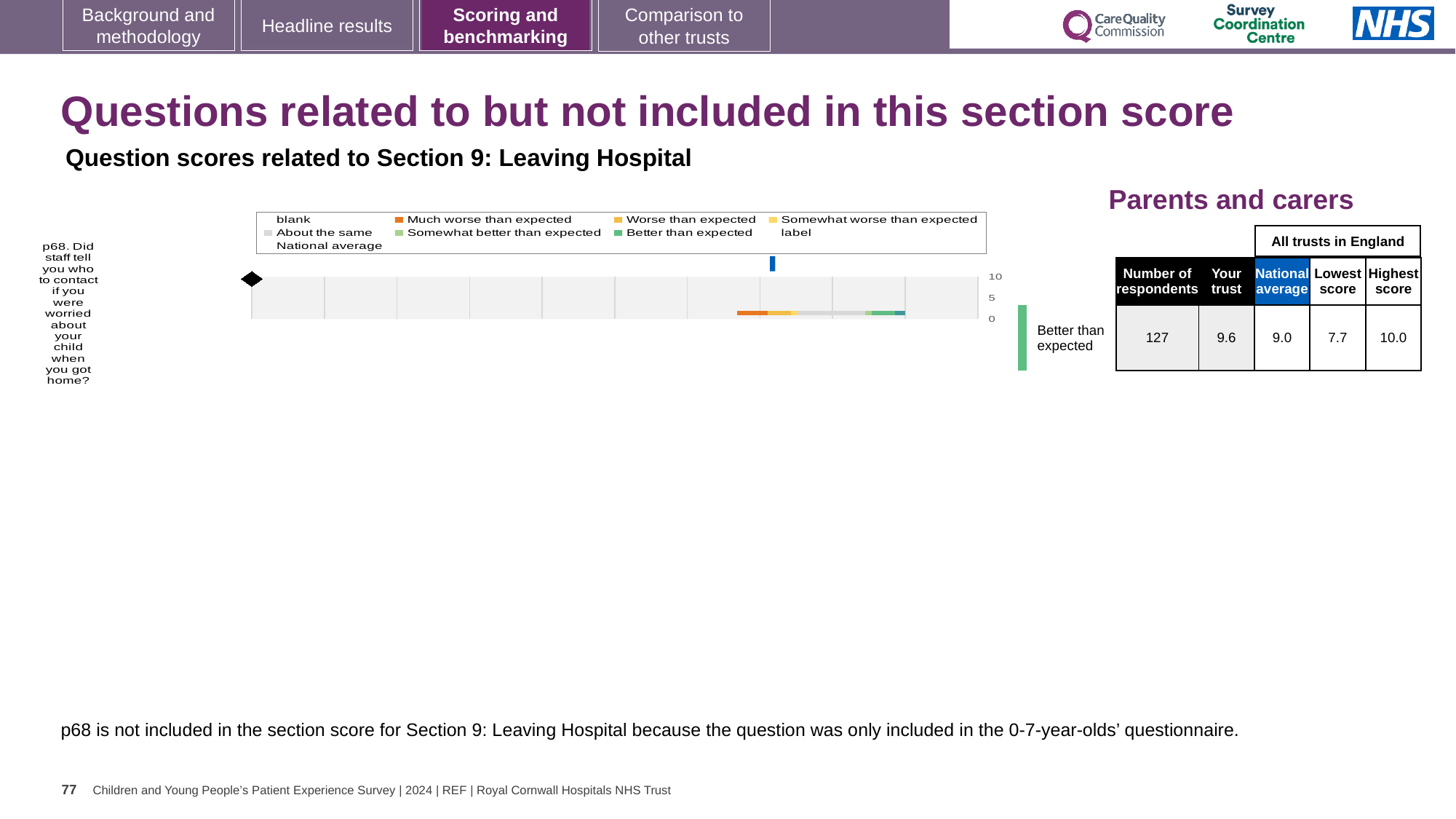
What is the 'Your trust' score for question p68? 9.6 What is the national average score for question p68? 9.0 What is the highest score among all trusts in England for question p68? 10.0 What is the lowest score among all trusts in England for question p68? 7.7 Which colour in the legend represents 'Much worse than expected'? orange How many survey questions are plotted in the chart? 1 Which rating category is shown next to the chart for the trust's result on p68? Better than expected What is the difference between the 'Your trust' score and the national average for question p68? 0.6 How many respondents answered question p68? 127 How many entries does the legend of the p68 chart list? 9 Which is higher for question p68: the 'Your trust' score or the national average? Your trust What kind of chart is shown on the slide for question p68? bar chart